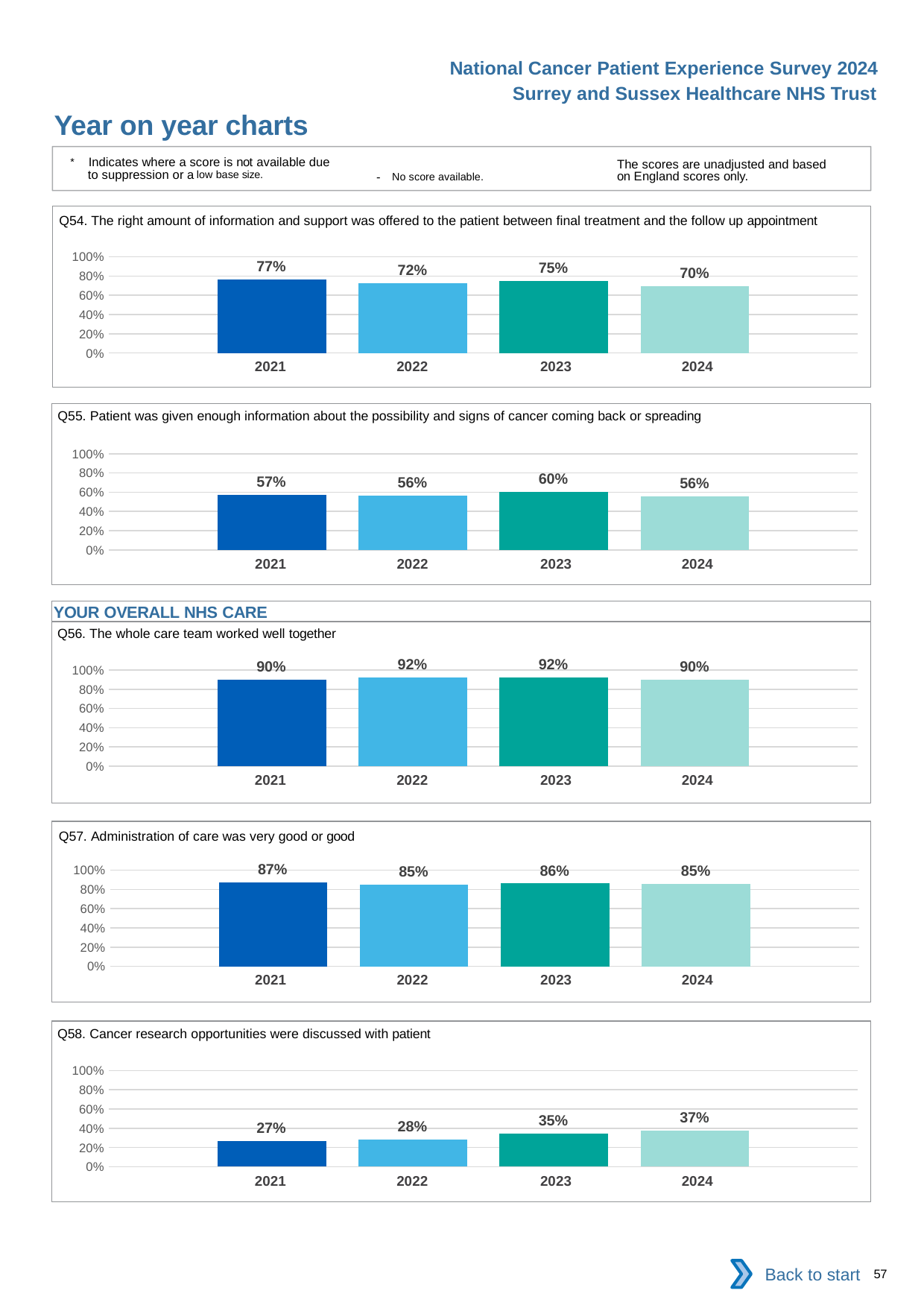
In the Q57 chart, what is the value for 2024? 85% In the Q58 chart, do the values rise or fall from 2021 to 2024? rise In the Q57 chart, which is larger, the value for 2021 or the value for 2023? 2021 In the Q58 chart, is the value for 2023 greater or less than 40%? less What kind of chart is the Q58 chart? bar chart In the Q54 chart, what is the value for 2021? 77% In the Q56 chart, how many years are shown on the x axis? 4 In the Q55 chart, which year has the highest value? 2023 In the Q55 chart, what is the difference between the 2023 and 2024 values? 4 percentage points In the Q56 chart, what is the value for 2022? 92% In the Q54 chart, which year has the lowest value? 2024 In the Q58 chart, what is the difference between the 2024 and 2021 values? 10 percentage points